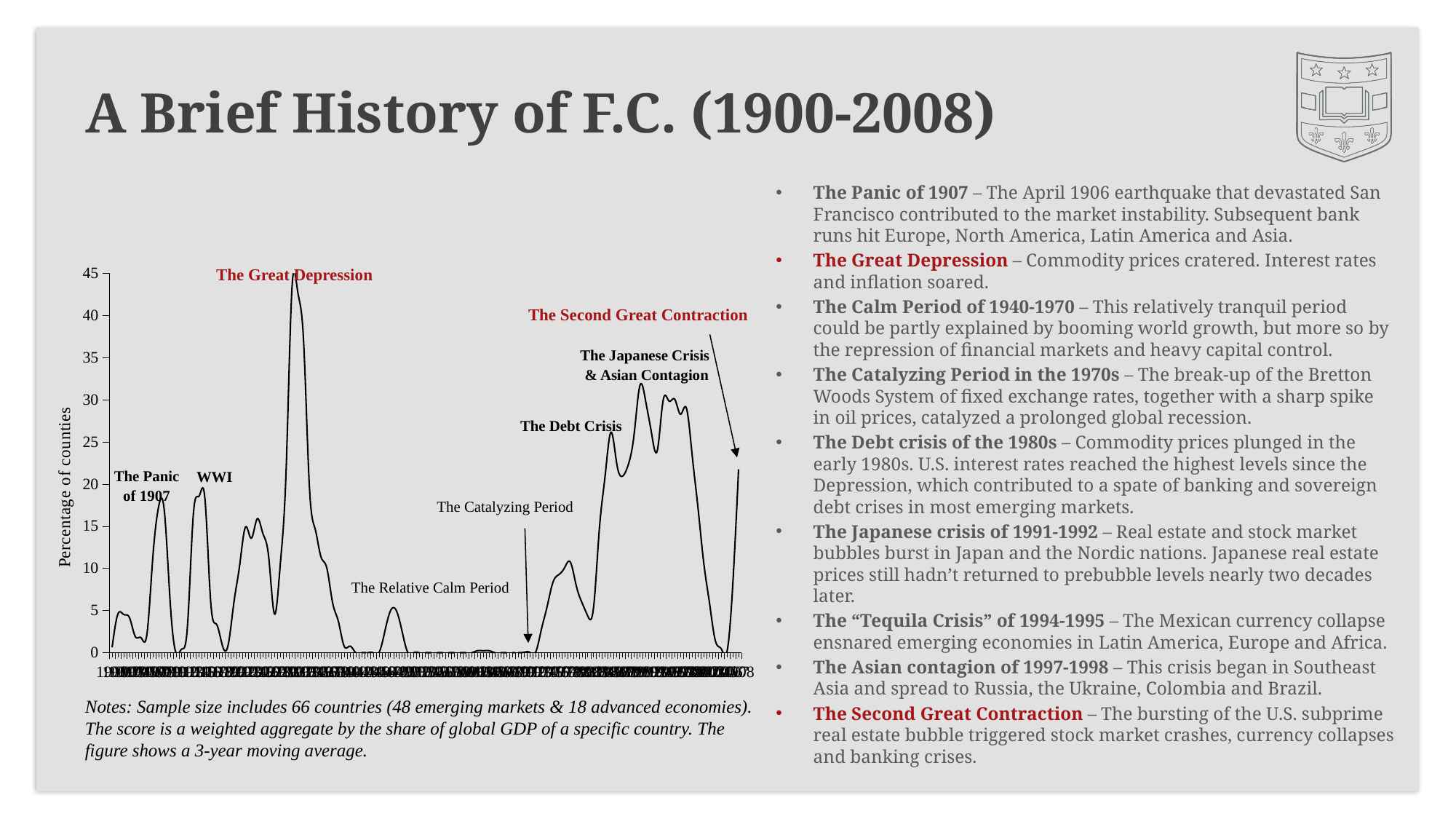
Is the peak value during The Japanese Crisis & Asian Contagion greater or less than 30? greater What is the label on the vertical axis of the chart? Percentage of counties Is the peak value during The Debt Crisis greater or less than 20? greater Is the peak value during The Panic of 1907 greater or less than 20? less Which peak is higher on the chart, The Great Depression or The Debt Crisis? The Great Depression What kind of chart is shown on the slide? line chart What is the highest tick value shown on the vertical axis of the chart? 45 Which annotated period on the chart has the highest peak? The Great Depression Which peak is higher on the chart, The Japanese Crisis & Asian Contagion or The Panic of 1907? The Japanese Crisis & Asian Contagion